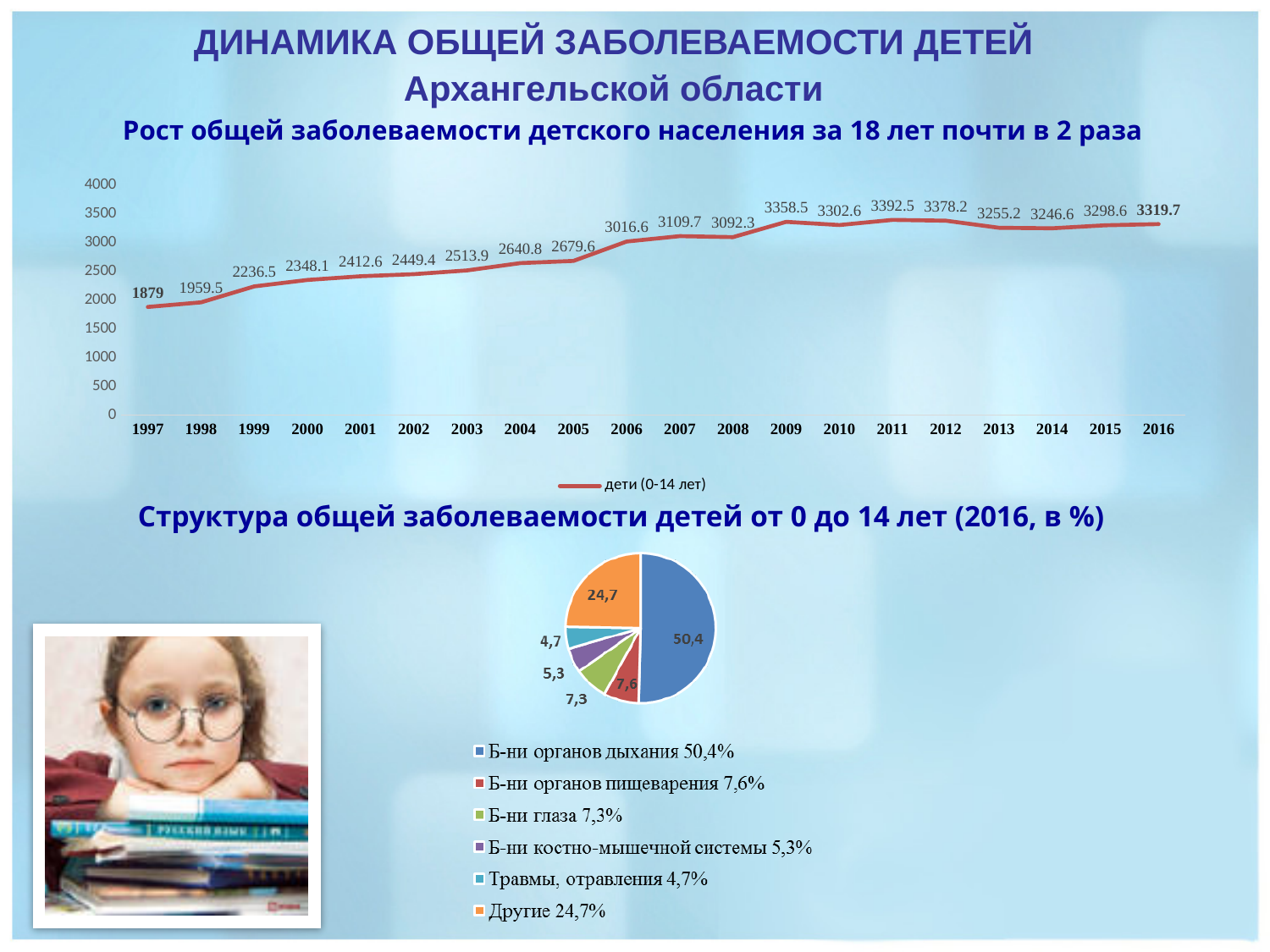
In the bottom pie chart, what is the difference between the shares of 'Б-ни органов дыхания' and 'Другие'? 25,7% In the top line chart, which year has the highest value? 2011 In the top line chart, which is larger: the value for 2009 or the value for 2010? 2009 In the top line chart, what is the difference between the values for 2016 and 1997? 1440.7 In the top line chart, what is the value for 2016? 3319.7 In the bottom pie chart, what share does 'Б-ни органов дыхания' have? 50,4% In the top line chart, what is the value for 1997? 1879 What type of chart is the top chart on the slide? line chart In the top line chart, how many years are plotted? 20 In the bottom pie chart, how many slices are there? 6 In the top line chart, do the values generally rise or fall from 1997 to 2016? rise In the top line chart, which year has the lowest value? 1997